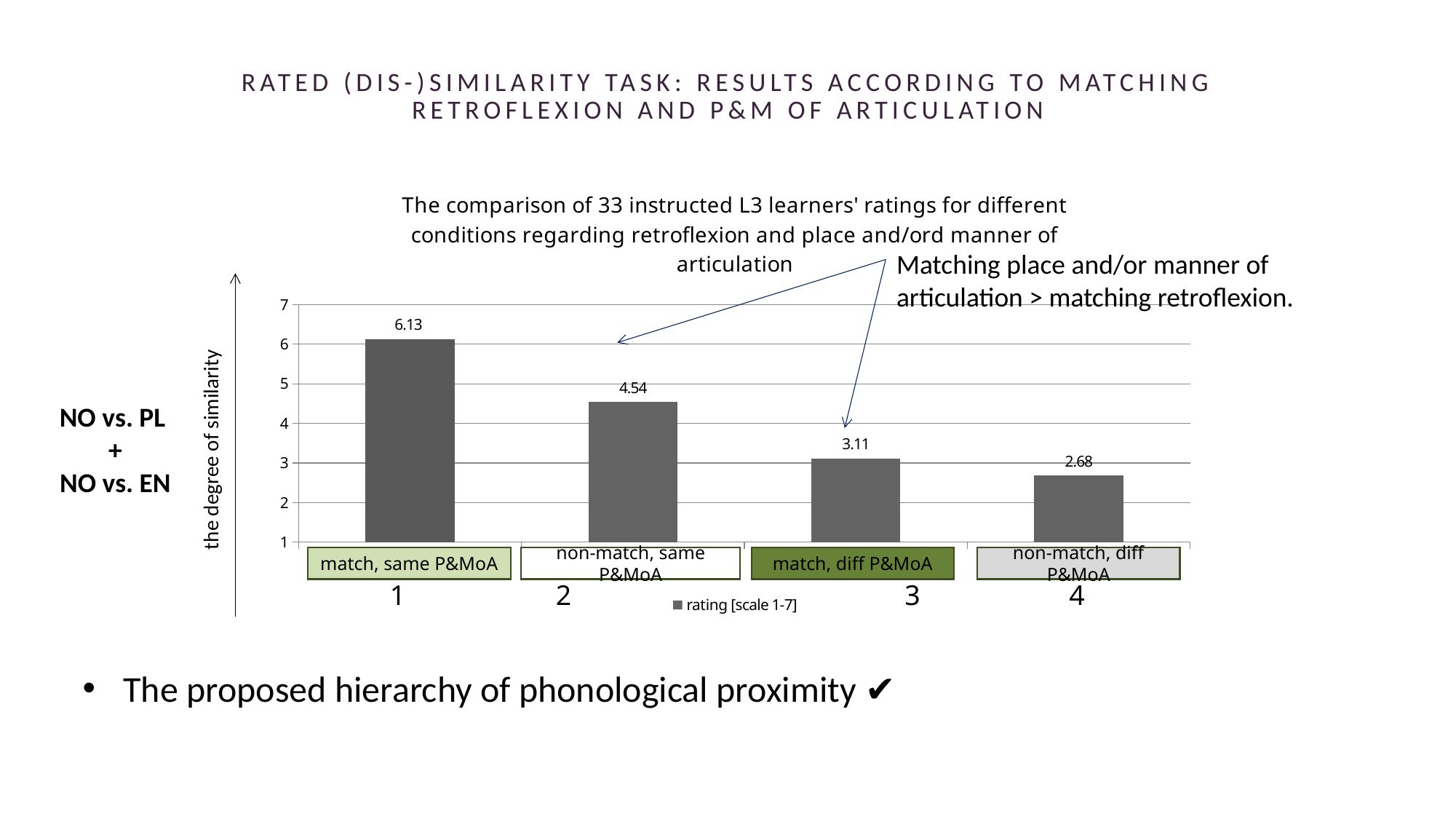
What is the rating for the 'non-match, diff P&MoA' condition? 2.68 How many series does the legend list? 1 Which has a higher rating: 'non-match, same P&MoA' or 'match, diff P&MoA'? non-match, same P&MoA What is the difference between the ratings for 'match, same P&MoA' and 'non-match, same P&MoA'? 1.59 Which condition has the lowest rating? non-match, diff P&MoA What is the rating for the 'match, same P&MoA' condition? 6.13 What is the rating for the 'match, diff P&MoA' condition? 3.11 How many conditions (bars) are shown in the chart? 4 What kind of chart is shown on the slide? bar chart Do the ratings rise or fall from condition 1 to condition 4? fall Which condition has the highest rating? match, same P&MoA What is the rating for the 'non-match, same P&MoA' condition? 4.54